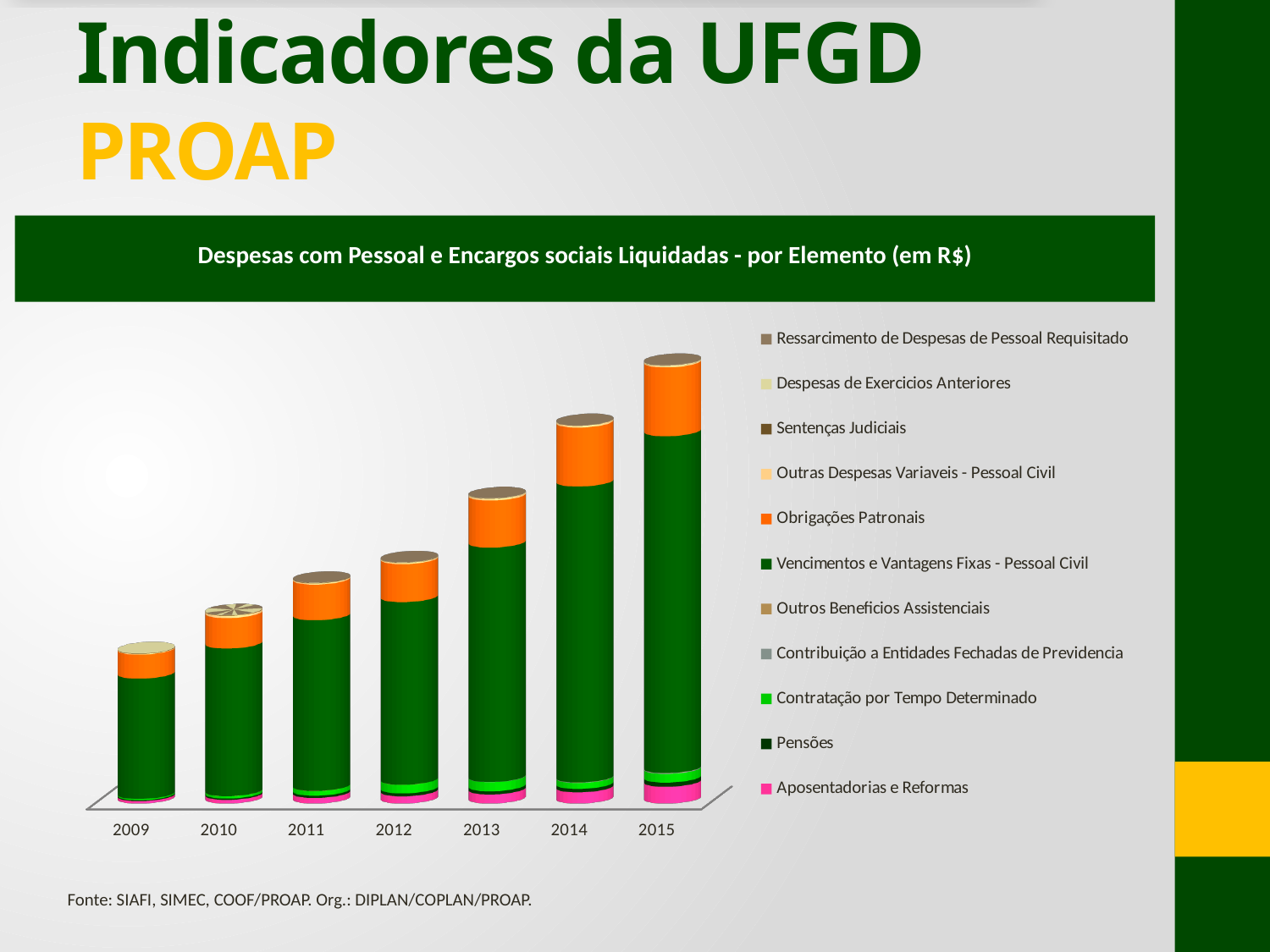
What kind of chart is shown on the slide? Stacked bar chart Which series makes up the largest part of each bar? Vencimentos e Vantagens Fixas - Pessoal Civil How many years are shown along the x axis of the chart? 7 Which year has the tallest stacked bar? 2015 What is the last year shown on the x axis? 2015 Which year has the shortest stacked bar? 2009 What is the first year shown on the x axis? 2009 Which year has a taller stacked bar, 2011 or 2014? 2014 Which year has a taller stacked bar, 2010 or 2009? 2010 What is the title of the chart? Despesas com Pessoal e Encargos sociais Liquidadas - por Elemento (em R$) Do the total expenses rise or fall from 2009 to 2015? Rise How many series does the chart's legend list? 11